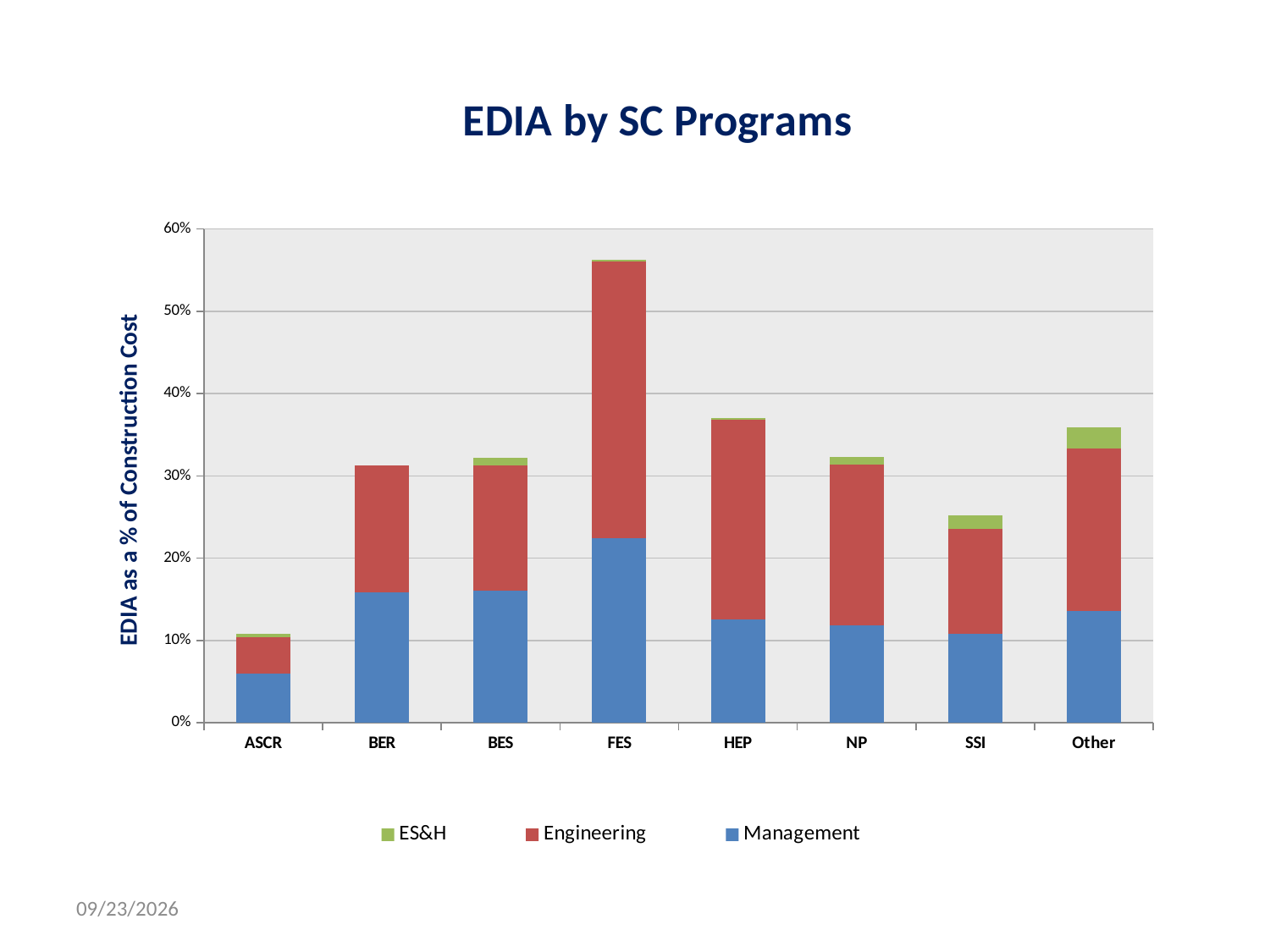
Which program has the largest Management segment? FES Is the total value for FES greater or less than 50%? greater Is the total value for HEP greater or less than 40%? less How many series does the legend list? 3 Which program has the highest total EDIA as a % of construction cost? FES Is the total value for SSI greater or less than 20%? greater What kind of chart is shown on the slide? Stacked bar chart What is the title of the y axis? EDIA as a % of Construction Cost Which has the larger total EDIA percentage, SSI or Other? Other Which program has the lowest total EDIA as a % of construction cost? ASCR How many SC programs (categories) are shown on the x axis? 8